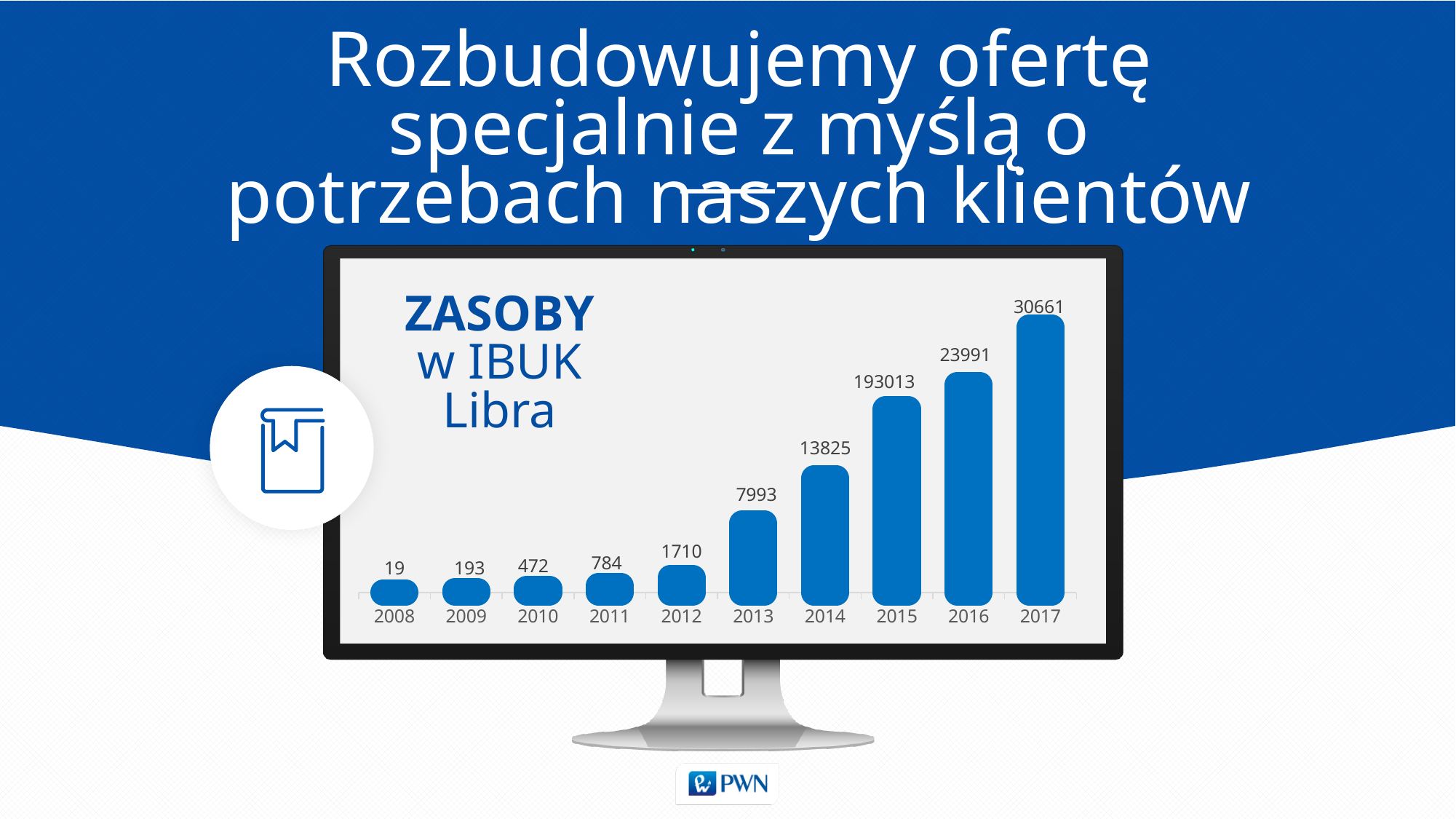
Do the values rise or fall from 2008 to 2017? Rise What is the difference between the values for 2014 and 2013? 5832 Which year has the tallest bar in the chart? 2017 What value is labelled on the bar for 2013? 7993 What value is shown for 2008 in the chart? 19 Which is larger, the value for 2012 or the value for 2011? 2012 What type of chart is shown on the monitor screen? Bar chart How many years are shown on the x axis of the chart? 10 What is the difference between the values for 2017 and 2016? 6670 What value is shown for 2017 in the ZASOBY w IBUK Libra chart? 30661 Which year has the lowest value in the chart? 2008 What value is labelled on the bar for 2015? 193013